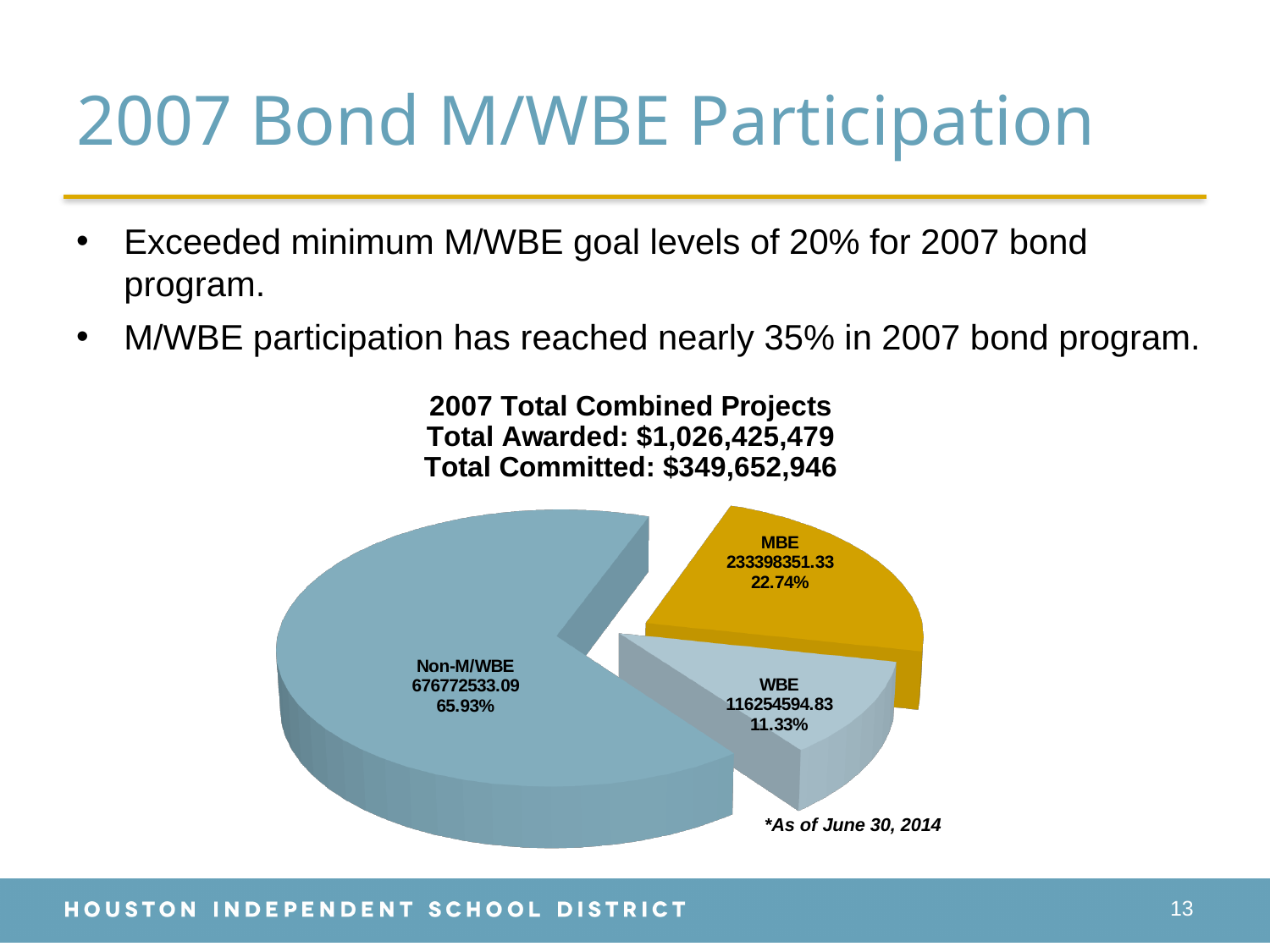
What percentage share does the Non-M/WBE slice represent? 65.93% Which slice of the pie chart is the smallest? WBE Which slice is larger, MBE or WBE? MBE What is the value labelled on the WBE slice? 116254594.83 Which slice of the pie chart is the largest? Non-M/WBE What percentage share does the MBE slice represent? 22.74% What percentage share does the WBE slice represent? 11.33% How many slices does the pie chart have? 3 What kind of chart is shown on the slide? pie chart What is the difference in percentage points between the MBE and WBE shares? 11.41 What is the value labelled on the Non-M/WBE slice? 676772533.09 What is the value labelled on the MBE slice? 233398351.33